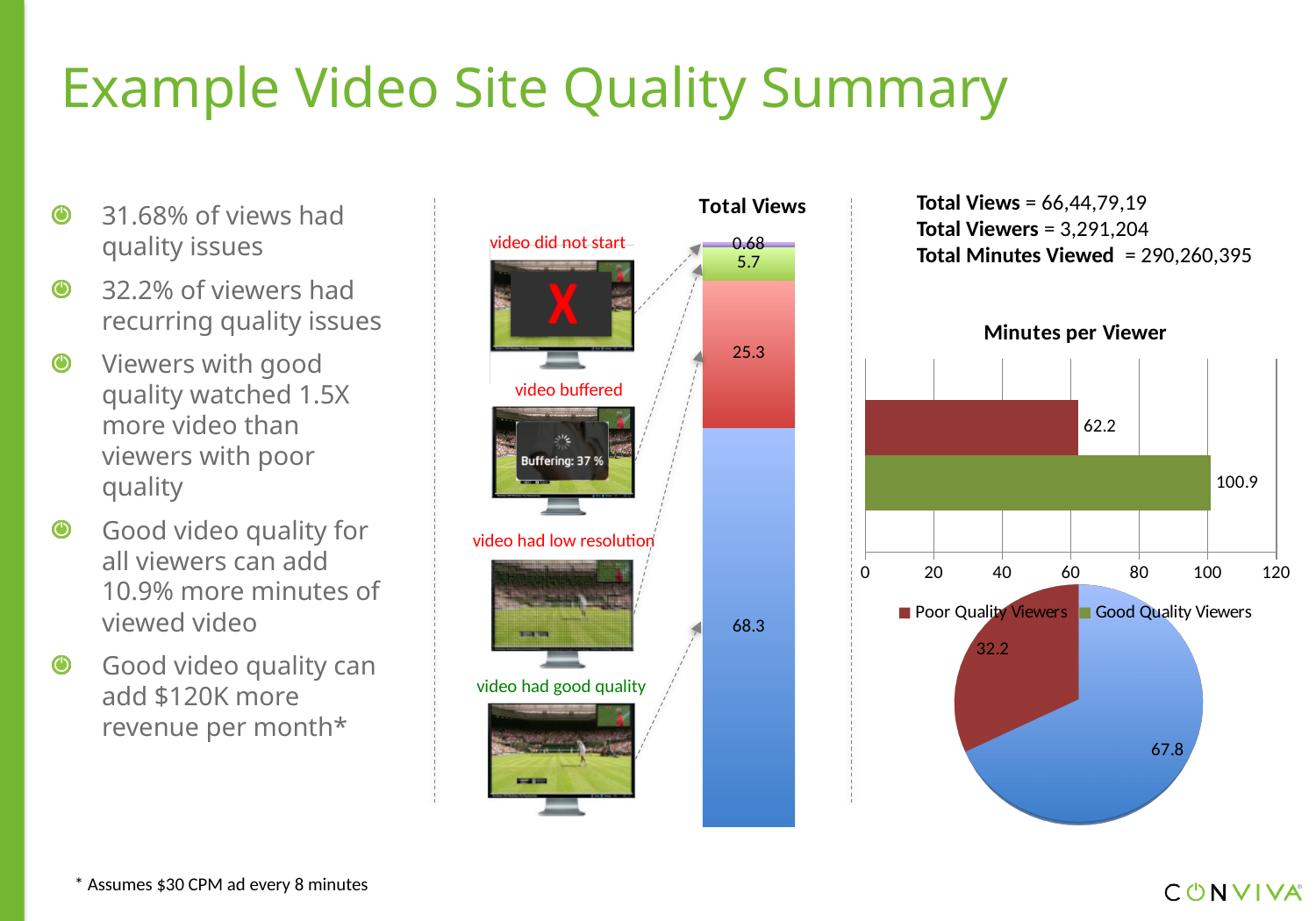
What kind of chart is the Minutes per Viewer chart? bar chart In the Total Views stacked bar, which segment is the smallest? video did not start In the pie chart, what is the value shown for the Poor Quality Viewers slice? 32.2 In the Total Views stacked bar, what is the value for the segment labelled 'video buffered'? 5.7 In the Minutes per Viewer chart, which group has the higher value? Good Quality Viewers In the Minutes per Viewer chart, what is the value for Poor Quality Viewers? 62.2 In the Minutes per Viewer chart, what is the value for Good Quality Viewers? 100.9 In the Total Views stacked bar, how many segments are there? 4 In the Total Views stacked bar, what is the value for the segment labelled 'video had good quality'? 68.3 In the Minutes per Viewer chart, is the value for Poor Quality Viewers greater or less than 80? less In the Minutes per Viewer chart, what is the difference between Good Quality Viewers and Poor Quality Viewers? 38.7